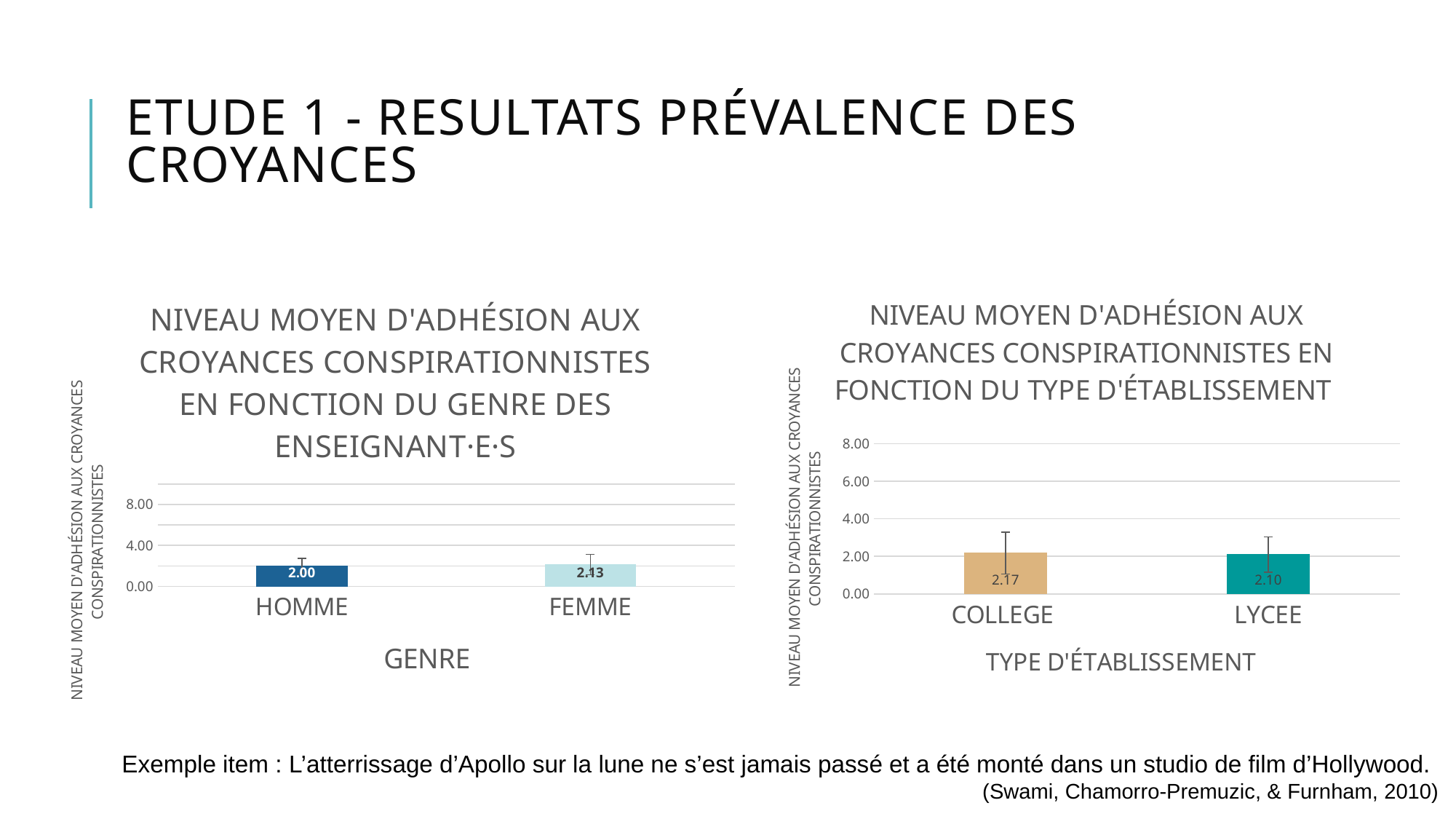
In the chart on the left (by genre), what is the difference between the values for FEMME and HOMME? 0.13 In the chart on the right (by type d'établissement), what is the value for LYCEE? 2.10 What is the x-axis title of the chart on the right? TYPE D'ÉTABLISSEMENT In the chart on the left (by genre), which category has the higher value according to the data labels, HOMME or FEMME? FEMME In the chart on the right (by type d'établissement), what is the value for COLLEGE? 2.17 In the chart on the left (by genre), what is the value for HOMME? 2.00 In the chart on the right (by type d'établissement), which category has the higher value according to the data labels, COLLEGE or LYCEE? COLLEGE How many categories are shown in the chart on the right (by type d'établissement)? 2 In the chart on the right (by type d'établissement), what is the difference between the values for COLLEGE and LYCEE? 0.07 In the chart on the left (by genre), is the value for HOMME greater or less than 4.00? less In the chart on the left (by genre), what is the value for FEMME? 2.13 What type of chart is the chart on the left (by genre)? Bar chart